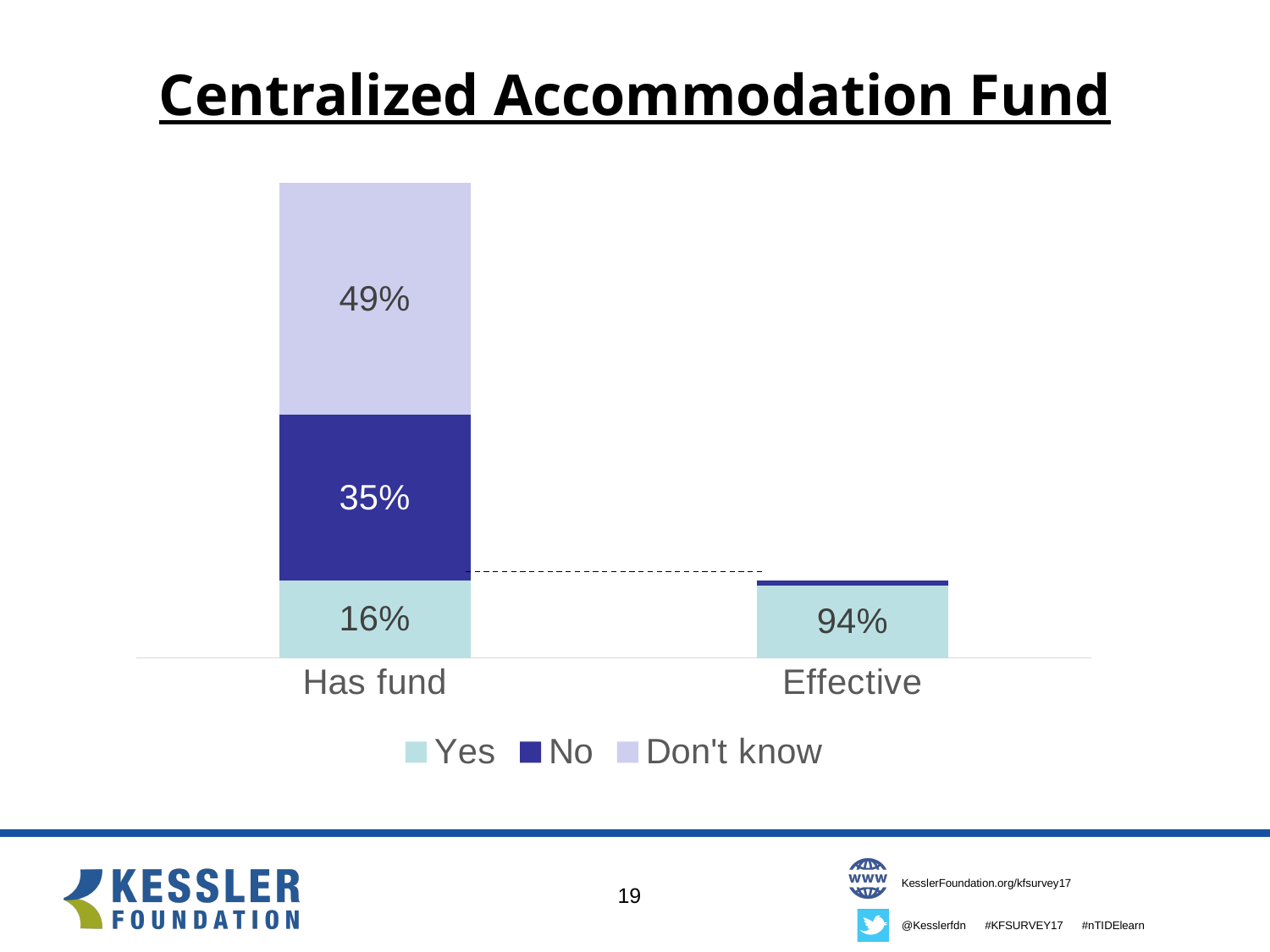
How many series does the legend list? 3 What is the title of the slide? Centralized Accommodation Fund What percentage of the "Has fund" bar is "Don't know"? 49% What percentage of the "Has fund" bar is "No"? 35% What kind of chart is shown on the slide? Stacked bar chart What percentage of the "Has fund" bar is "Yes"? 16% What is the "Yes" value for the "Effective" category? 94% How many categories are shown on the x axis? 2 Which response has the smallest share in the "Has fund" bar? Yes Which response has the largest share in the "Has fund" bar? Don't know What is the difference between the "Don't know" and "No" values in the "Has fund" bar? 14% Which is larger: the "Yes" value for "Effective" or the "Yes" value for "Has fund"? Effective